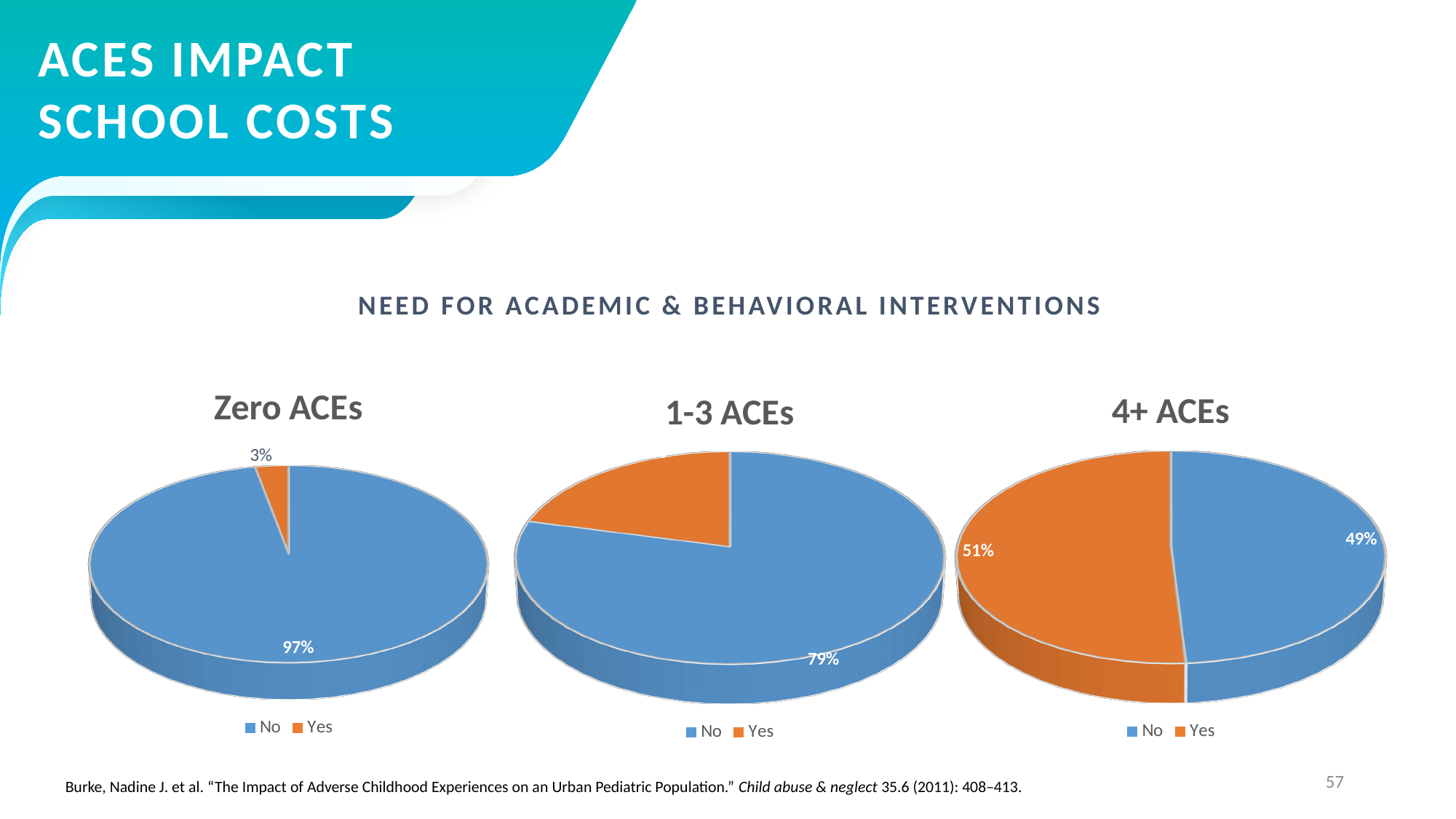
In the "4+ ACEs" chart, what share of the pie is "Yes"? 51% What kind of chart is the "Zero ACEs" chart? pie chart What is the heading shown above the three pie charts? NEED FOR ACADEMIC & BEHAVIORAL INTERVENTIONS In the "Zero ACEs" chart, what share of the pie is "No"? 97% In the "Zero ACEs" chart, which slice is the smallest? Yes In the "1-3 ACEs" chart, what share of the pie is "No"? 79% In the "1-3 ACEs" chart, which slice is the largest? No In the "Zero ACEs" chart, what is the difference between the "No" and "Yes" shares? 94% How many entries does the legend of the "4+ ACEs" chart list? 2 In the "4+ ACEs" chart, which slice is larger, "No" or "Yes"? Yes